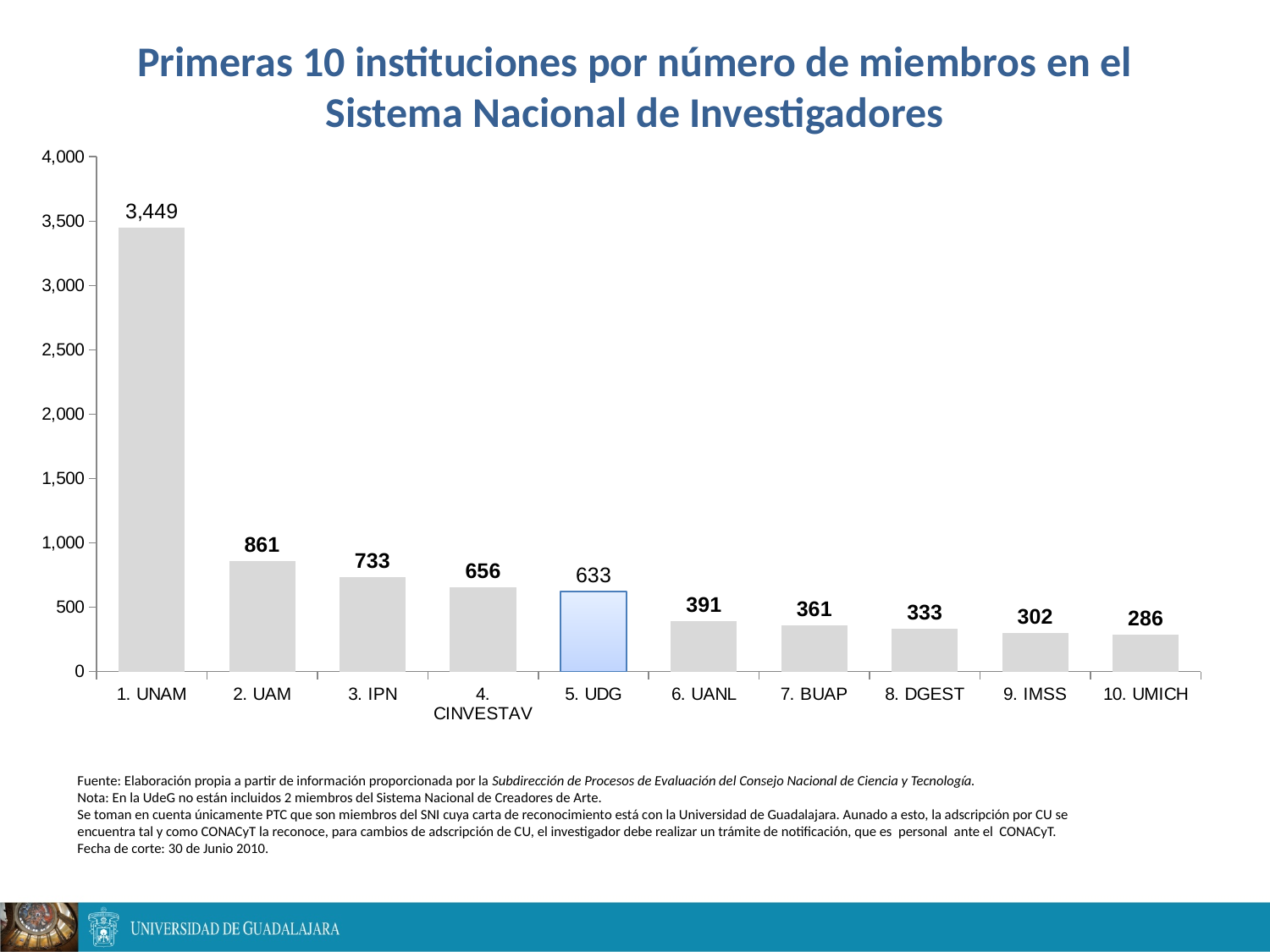
Which institution has the lowest number of members? 10. UMICH What is the difference between the values for 2. UAM and 3. IPN? 128 How many institutions are shown in the chart? 10 What is the value for 5. UDG? 633 What is the value for 1. UNAM? 3,449 Which institution has the highest number of members? 1. UNAM What is the difference between the values for 4. CINVESTAV and 5. UDG? 23 Is the value for 9. IMSS greater or less than 500? less Which is larger, the value for 6. UANL or the value for 7. BUAP? 6. UANL What kind of chart is shown on the slide? bar chart Which bar is highlighted in a different colour (blue) from the others? 5. UDG What is the value for 8. DGEST? 333